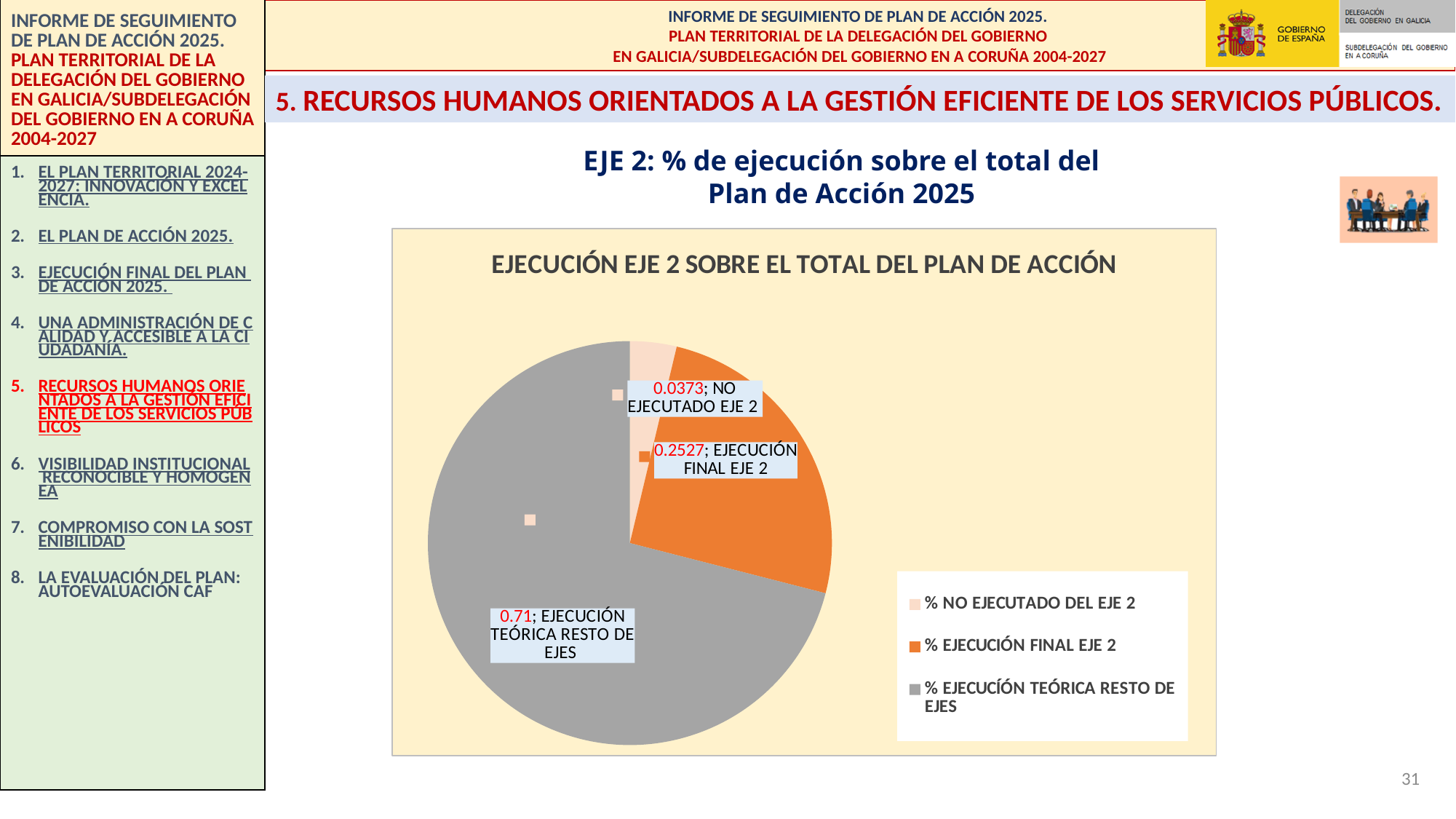
Which is larger, EJECUCIÓN FINAL EJE 2 or NO EJECUTADO EJE 2? EJECUCIÓN FINAL EJE 2 How many entries does the legend list? 3 Which slice of the pie is the largest? EJECUCIÓN TEÓRICA RESTO DE EJES What is the title of the chart? EJECUCIÓN EJE 2 SOBRE EL TOTAL DEL PLAN DE ACCIÓN What colour is the slice for EJECUCIÓN FINAL EJE 2? orange What is the value for EJECUCIÓN FINAL EJE 2? 0.2527 How many slices does the pie chart have? 3 Which slice of the pie is the smallest? NO EJECUTADO EJE 2 What kind of chart is shown on the slide? pie chart What is the value for NO EJECUTADO EJE 2? 0.0373 What is the difference between the values for EJECUCIÓN FINAL EJE 2 and NO EJECUTADO EJE 2? 0.2154 What is the value for EJECUCIÓN TEÓRICA RESTO DE EJES? 0.71